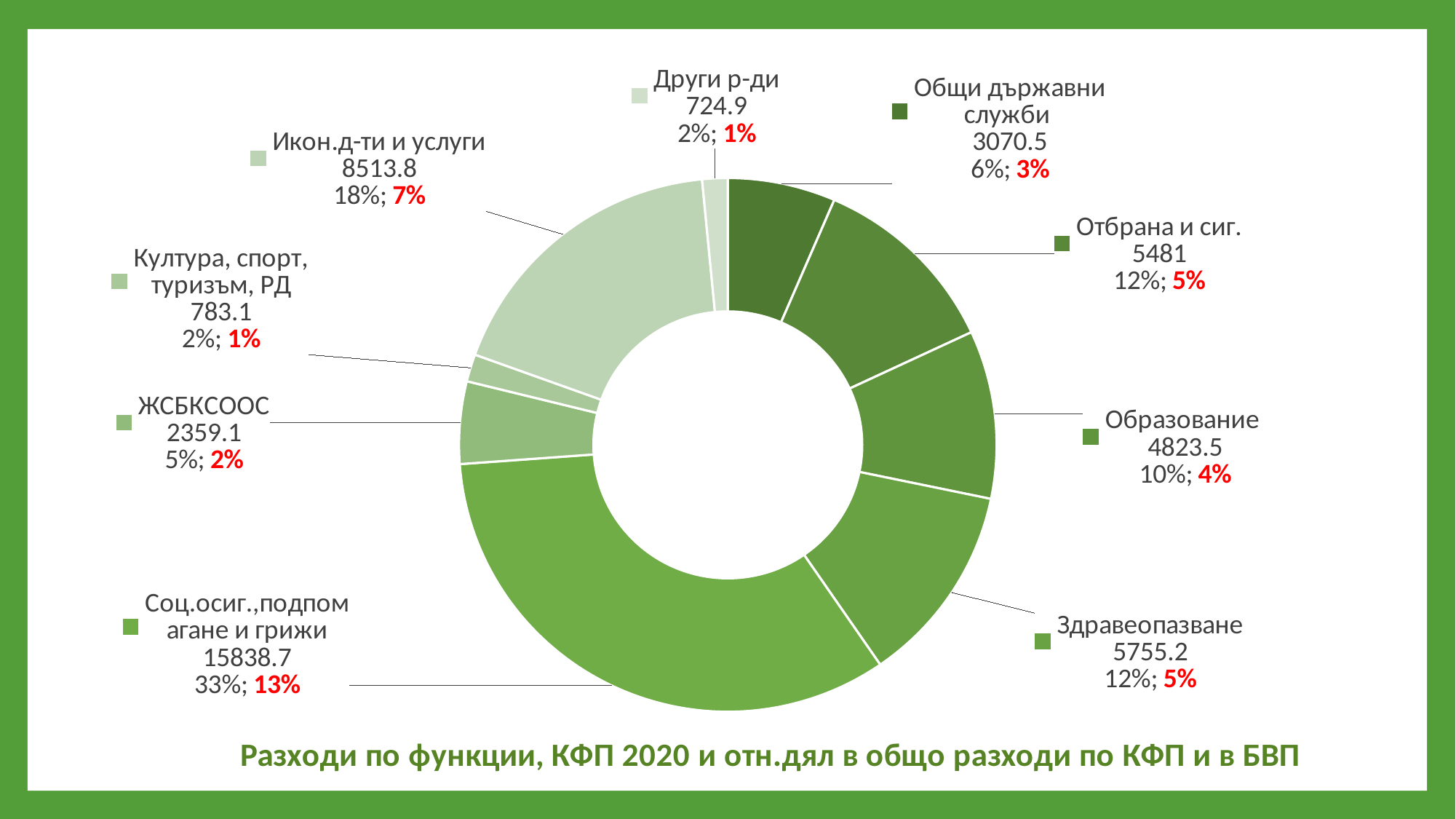
How many categories are shown in the chart? 9 What is the difference between the values for Здравеопазване and Отбрана и сиг.? 274.2 Which is larger, the value for Общи държавни служби or the value for ЖСБКСООС? Общи държавни служби What is the title of the chart? Разходи по функции, КФП 2020 и отн.дял в общо разходи по КФП и в БВП What value is shown for Образование? 4823.5 What kind of chart is shown on the slide? Doughnut chart Which category has the largest value? Соц.осиг.,подпомагане и грижи What share of the total does Соц.осиг.,подпомагане и грижи represent? 33% What value is shown for Здравеопазване? 5755.2 What share of the total does Отбрана и сиг. represent? 12% What value is shown for Икон.д-ти и услуги? 8513.8 Which category has the smallest value? Други р-ди